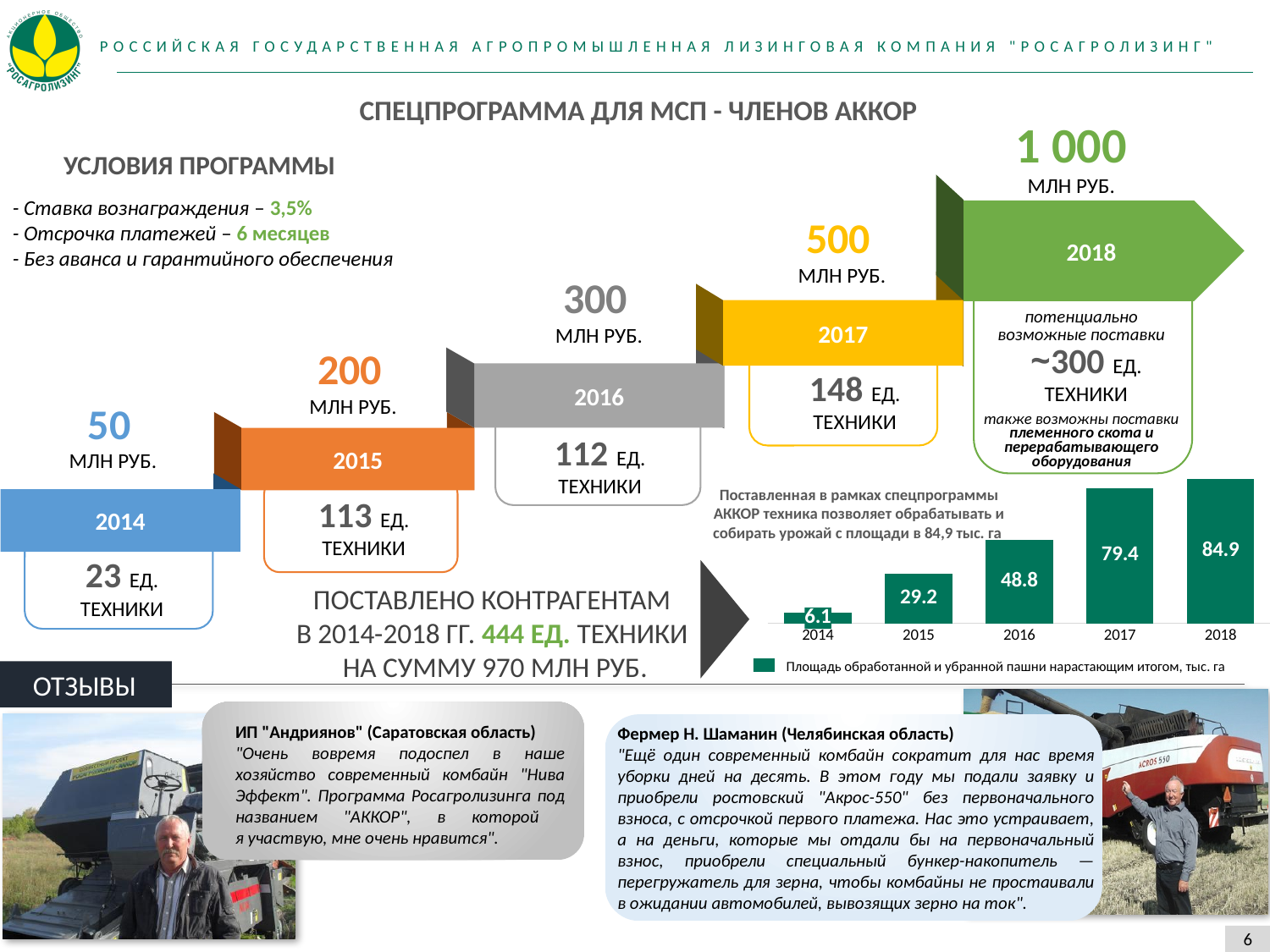
What kind of chart is shown on the right of the slide below the arrows? Bar chart How many years are shown on the x axis of the bar chart on the right of the slide? 5 In the bar chart on the right of the slide, what is the value for 2016? 48.8 In the bar chart on the right of the slide, what is the difference between the values for 2018 and 2017? 5.5 In the bar chart on the right of the slide, what is the difference between the values for 2016 and 2015? 19.6 In the bar chart on the right of the slide, which year has the highest value? 2018 In the bar chart on the right of the slide, which year has the lowest value? 2014 In the bar chart on the right of the slide, what is the value for 2017? 79.4 In the bar chart on the right of the slide, which is larger, the value for 2015 or the value for 2016? 2016 How many series does the legend of the bar chart on the right of the slide list? 1 In the bar chart on the right of the slide, what is the value for 2014? 6.1 In the bar chart on the right of the slide, do the values rise or fall from 2014 to 2018? Rise